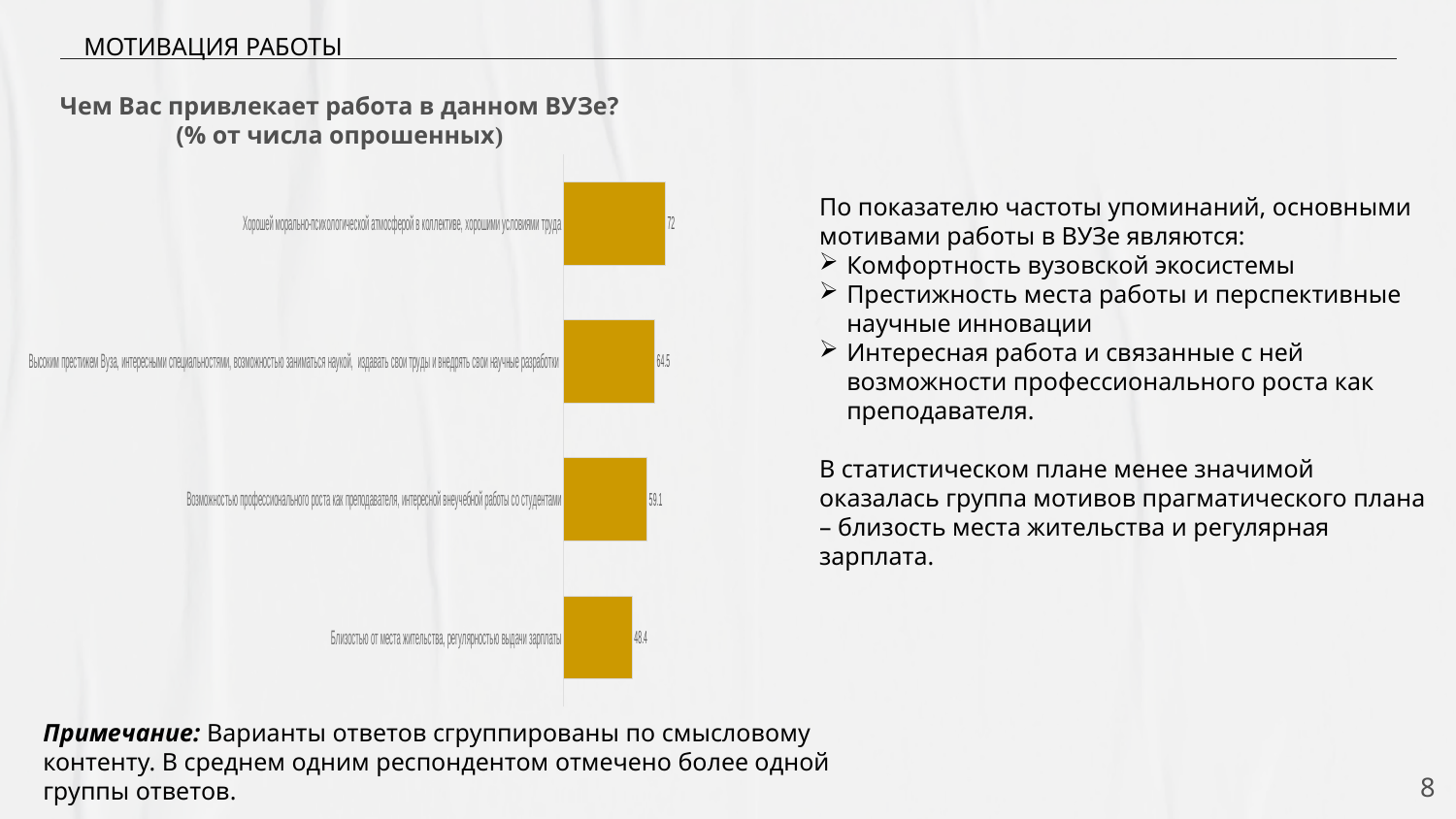
What is the value for "Возможностью профессионального роста как преподавателя, интересной внеучебной работы со студентами"? 59.1 What is the value for "Высоким престижем Вуза, интересными специальностями, возможностью заниматься наукой..."? 64.5 Which is larger: the value for "Высоким престижем Вуза..." or the value for "Возможностью профессионального роста как преподавателя..."? Высоким престижем Вуза... Which category has the lowest value in the chart? Близостью от места жительства, регулярностью выдачи зарплаты How many categories (bars) are shown in the chart? 4 What is the value for "Хорошей морально-психологической атмосферой в коллективе, хорошими условиями труда"? 72 What is the difference between the highest value (72) and the lowest value (48.4) in the chart? 23.6 What is the difference between the values for "Высоким престижем Вуза..." and "Возможностью профессионального роста как преподавателя..."? 5.4 What is the title of the chart? Чем Вас привлекает работа в данном ВУЗе? (% от числа опрошенных) What type of chart is shown on the slide? Bar chart What is the value for "Близостью от места жительства, регулярностью выдачи зарплаты"? 48.4 Which category has the highest value in the chart? Хорошей морально-психологической атмосферой в коллективе, хорошими условиями труда